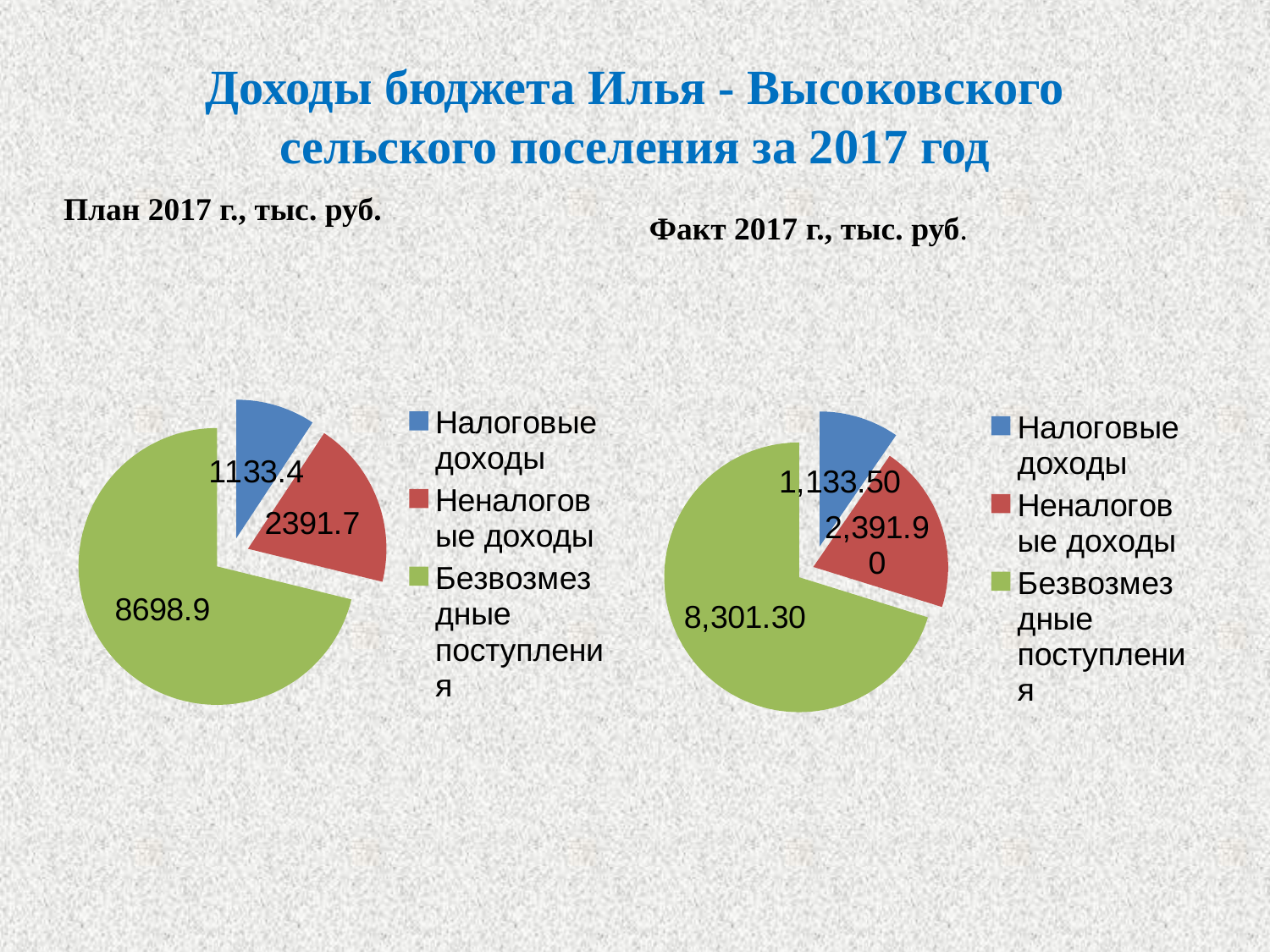
In the left pie chart (План 2017 г., тыс. руб.), what colour is the slice for Неналоговые доходы? Red How many slices does the right pie chart (Факт 2017 г., тыс. руб.) have? 3 In the left pie chart (План 2017 г., тыс. руб.), what is the difference between Неналоговые доходы and Налоговые доходы? 1258.3 In the right pie chart (Факт 2017 г., тыс. руб.), what is the value for Безвозмездные поступления? 8,301.30 In the left pie chart (План 2017 г., тыс. руб.), what is the value for Налоговые доходы? 1133.4 How many entries does the legend of the left chart (План 2017 г., тыс. руб.) list? 3 In the right pie chart (Факт 2017 г., тыс. руб.), what is the value for Неналоговые доходы? 2,391.90 In the left pie chart (План 2017 г., тыс. руб.), which category has the largest slice? Безвозмездные поступления In the left pie chart (План 2017 г., тыс. руб.), what is the value for Безвозмездные поступления? 8698.9 Comparing the two charts, is the value for Безвозмездные поступления larger in the План chart or the Факт chart? План In the right pie chart (Факт 2017 г., тыс. руб.), which category has the smallest slice? Налоговые доходы What type of chart is used for Факт 2017 г., тыс. руб.? Pie chart